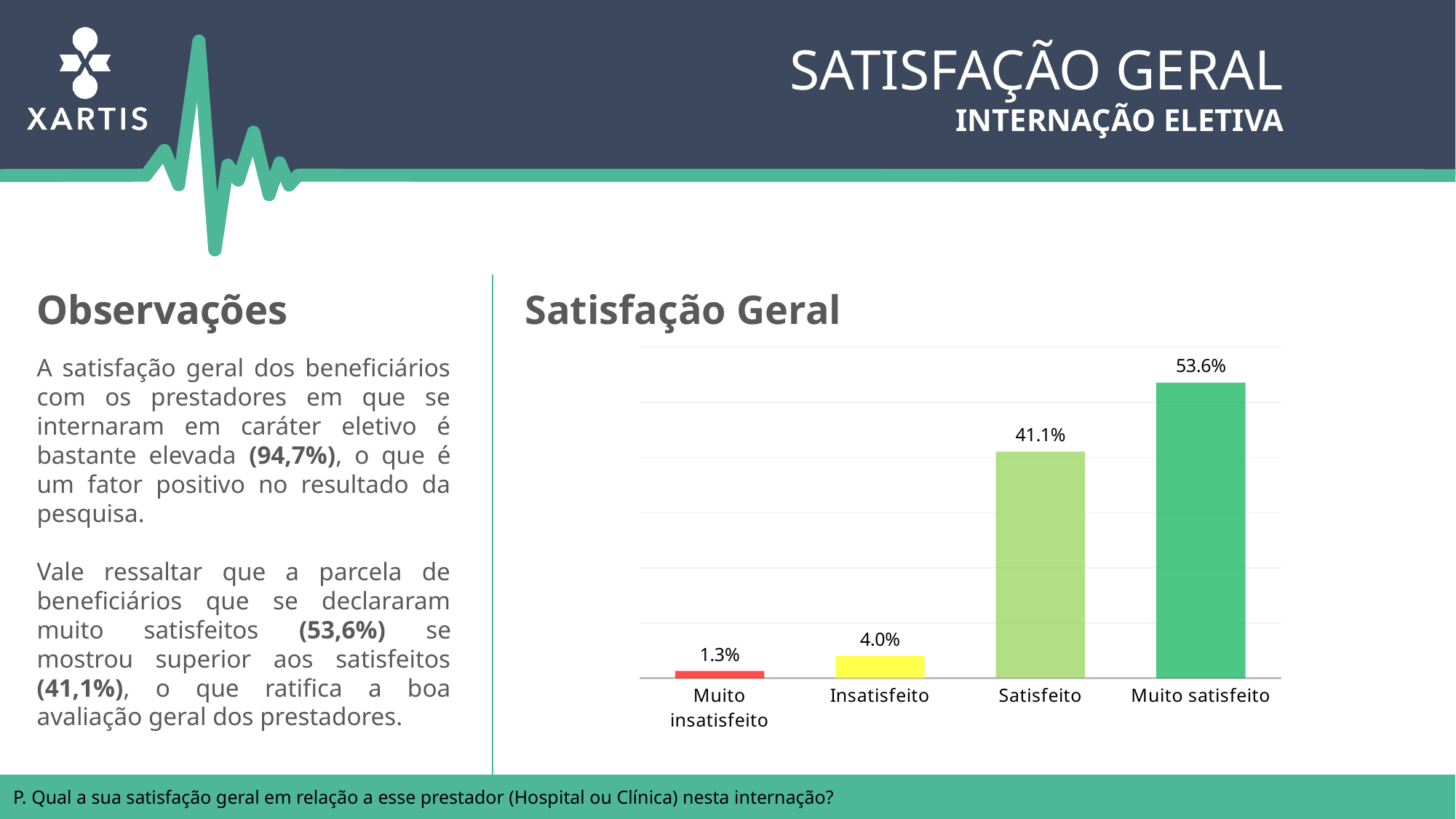
What kind of chart is shown on the slide? Bar chart What is the value for Muito satisfeito? 53.6% Which category has the highest value? Muito satisfeito What is the difference between the values for Insatisfeito and Muito insatisfeito? 2.7% How many categories are shown in the chart? 4 What is the value for Insatisfeito? 4.0% Which category has the lowest value? Muito insatisfeito What is the difference between the values for Muito satisfeito and Satisfeito? 12.5% What is the value for Satisfeito? 41.1% What is the value for Muito insatisfeito? 1.3% What is the title of the chart? Satisfação Geral Which is larger, the value for Satisfeito or the value for Insatisfeito? Satisfeito